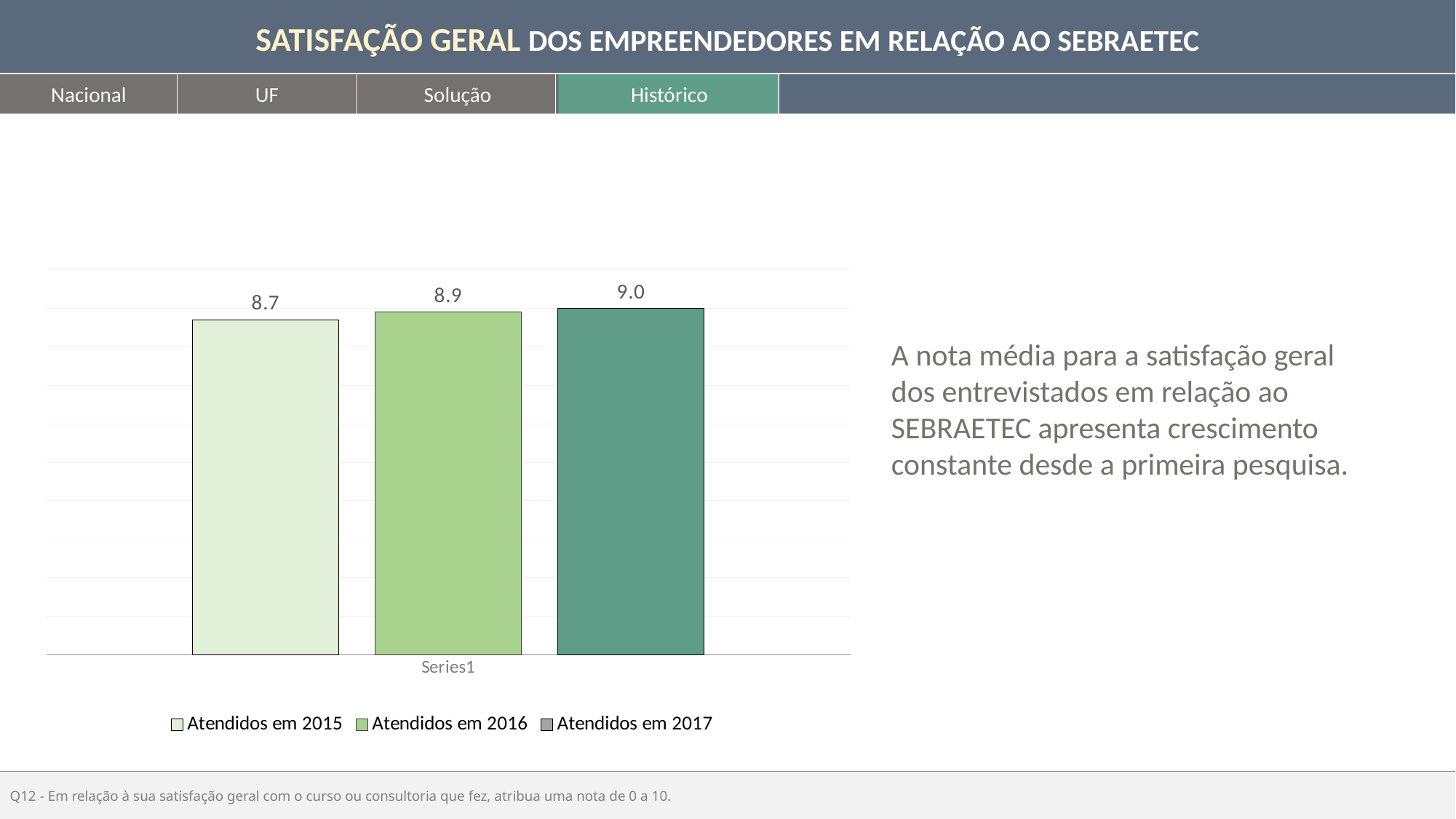
What is the difference between the values for Atendidos em 2017 and Atendidos em 2015? 0.3 What kind of chart is shown on the slide? Bar chart What is the value for Atendidos em 2017? 9.0 What is the value for Atendidos em 2016? 8.9 How many bars are plotted in the chart? 3 What is the value for Atendidos em 2015? 8.7 Which is larger, the value for Atendidos em 2016 or Atendidos em 2015? Atendidos em 2016 Which series has the lowest value? Atendidos em 2015 Which series has the highest value? Atendidos em 2017 How many series does the legend list? 3 Do the values rise or fall from Atendidos em 2015 to Atendidos em 2017? Rise What is the difference between the values for Atendidos em 2016 and Atendidos em 2015? 0.2